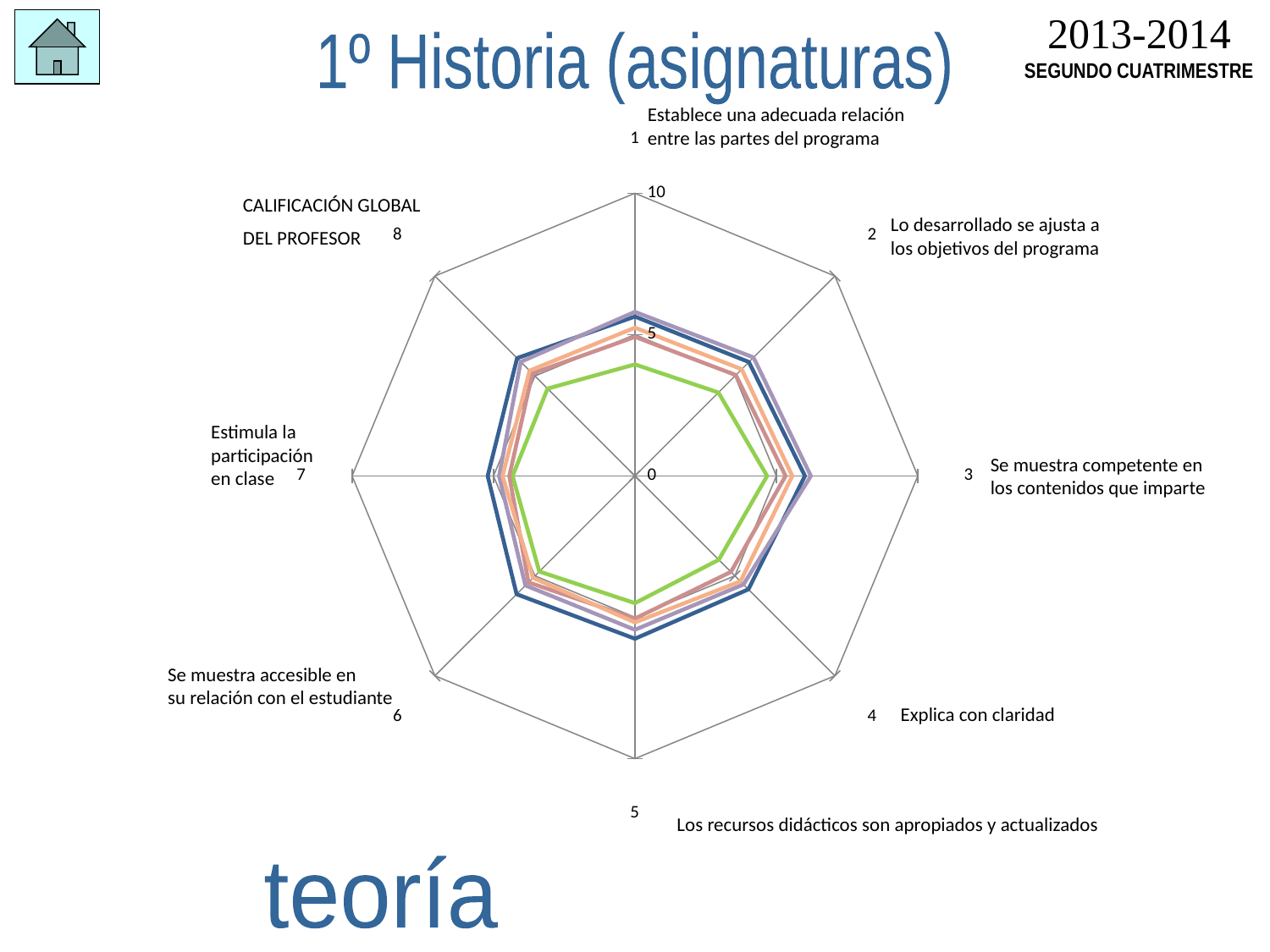
Which category is labelled with the number 5 on the radar chart? Los recursos didácticos son apropiados y actualizados Is the value of the green line for 'Estimula la participación en clase' greater or less than 5? less How many categories (axes) does the radar chart have? 8 For 'Explica con claridad', which line has the lower value, the green line or the dark blue line? green line Is the value of the dark blue line for 'Se muestra competente en los contenidos que imparte' greater or less than 5? greater What is the title of the slide containing the radar chart? 1º Historia (asignaturas) Is the value of the green line for 'Establece una adecuada relación entre las partes del programa' greater or less than 5? less What kind of chart is shown on the slide? Radar chart For 'Lo desarrollado se ajusta a los objetivos del programa', which line has the higher value, the dark blue line or the green line? dark blue line